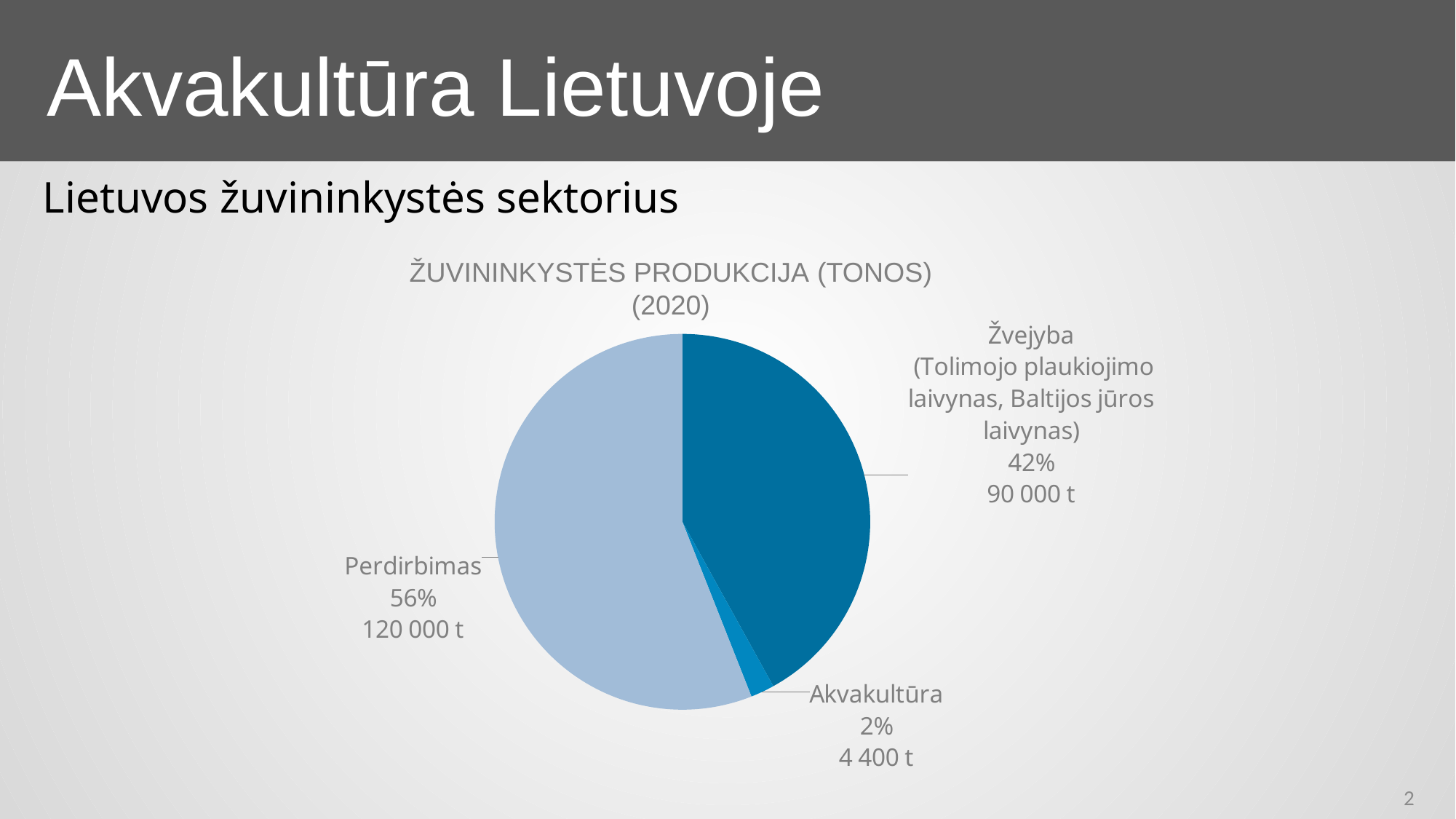
What is the value for Perdirbimas? 120 000 t What kind of chart is shown on the slide? pie chart Which is larger, Žvejyba or Akvakultūra? Žvejyba What is the difference in tonnes between Perdirbimas and Žvejyba? 30 000 t What is the value for Akvakultūra? 4 400 t How many slices does the pie chart have? 3 What is the value for Žvejyba? 90 000 t What share of the pie does Akvakultūra represent? 2% Which category has the smallest slice? Akvakultūra What share of the pie does Perdirbimas represent? 56% What is the title of the chart? ŽUVININKYSTĖS PRODUKCIJA (TONOS) (2020) Which category has the largest slice? Perdirbimas